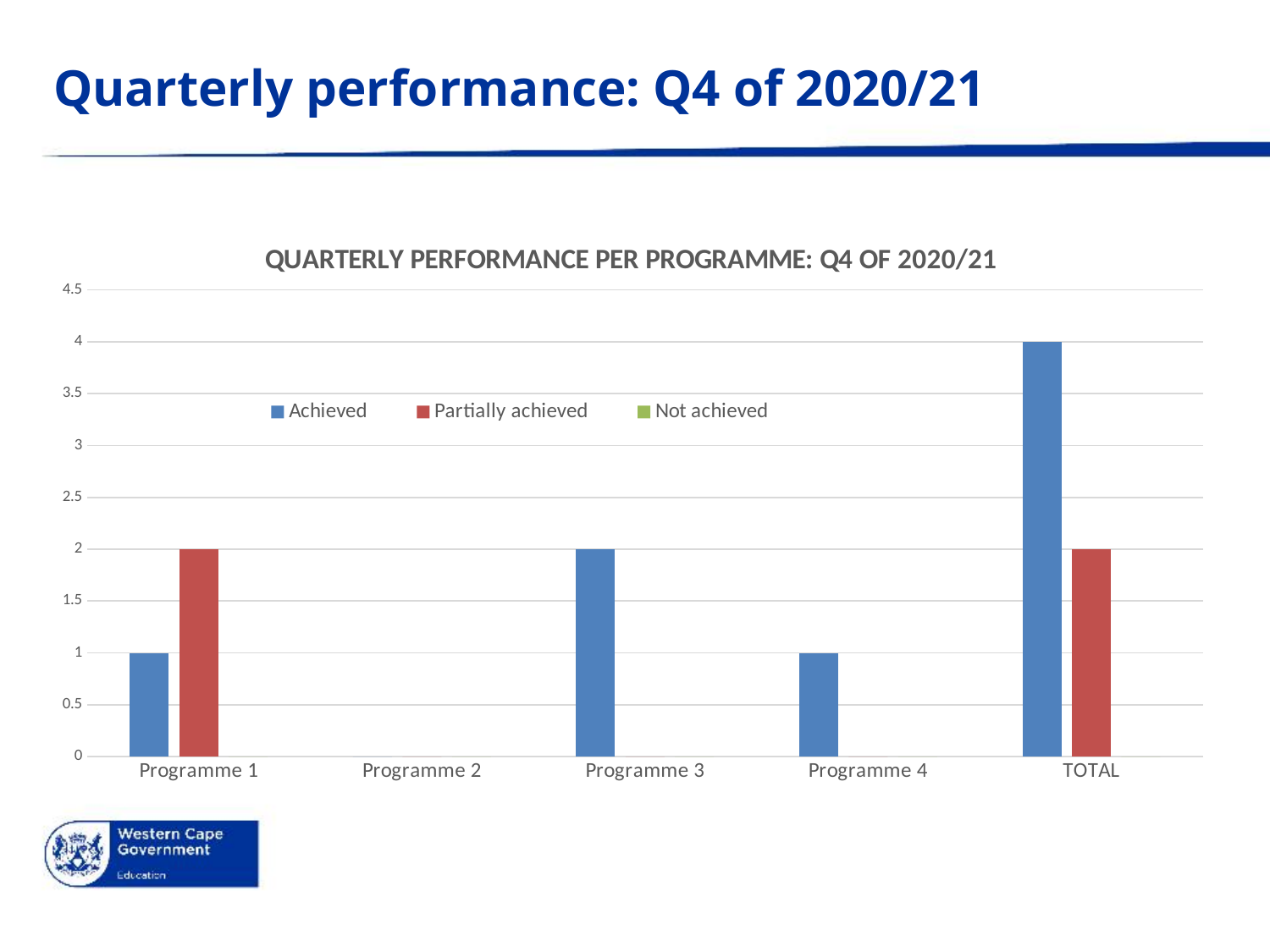
Which category has the highest Achieved value? TOTAL What is the Achieved value for Programme 3? 2 What is the Achieved value for TOTAL? 4 What is the difference between the Achieved value for TOTAL and the Achieved value for Programme 3? 2 What kind of chart is shown on the slide? Bar chart Which is larger for Programme 1: the Achieved value or the Partially achieved value? Partially achieved How many series does the legend list? 3 How many categories are shown on the x axis? 5 What is the Partially achieved value for Programme 1? 2 What is the Achieved value for Programme 4? 1 Is the Achieved value for TOTAL greater or less than 3? greater What is the title of the chart? QUARTERLY PERFORMANCE PER PROGRAMME: Q4 OF 2020/21